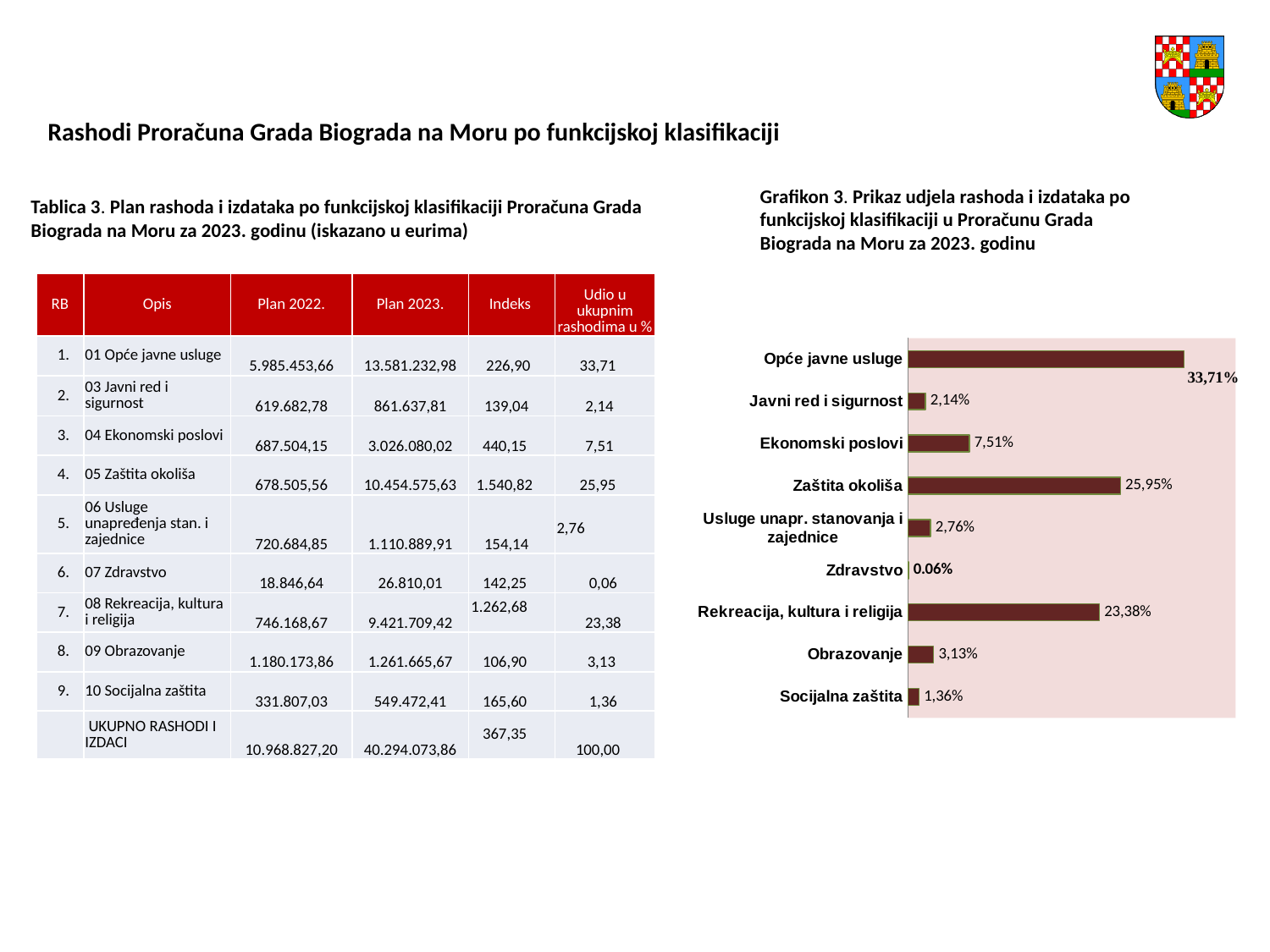
Which is larger in the chart, Obrazovanje or Socijalna zaštita? Obrazovanje What is the difference between the values for Opće javne usluge and Zaštita okoliša? 7,76% What is the value for Ekonomski poslovi in the chart? 7,51% Which category has the lowest value in the chart? Zdravstvo What is the value for Zdravstvo in the chart? 0.06% What type of chart is shown on the slide? bar chart What is the value for Rekreacija, kultura i religija in the chart? 23,38% What is the value for Opće javne usluge in the chart? 33,71% What is the value for Zaštita okoliša in the chart? 25,95% Which category has the highest value in the chart? Opće javne usluge What is the title of the chart? Grafikon 3. Prikaz udjela rashoda i izdataka po funkcijskoj klasifikaciji u Proračunu Grada Biograda na Moru za 2023. godinu How many categories are shown in the chart? 9